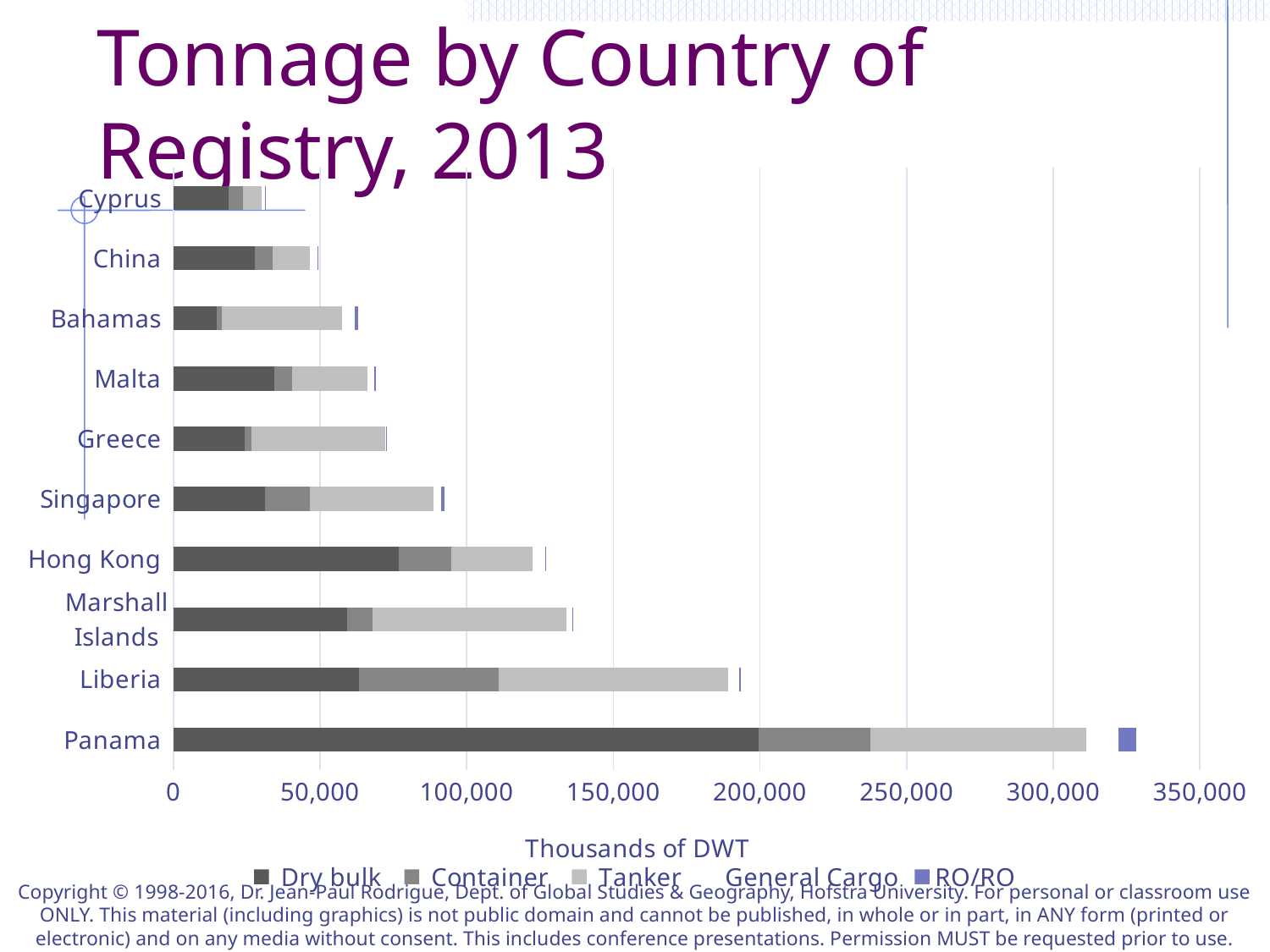
What kind of chart is shown on the slide? Stacked bar chart What is the first series listed in the legend? Dry bulk Is the total tonnage for Panama greater or less than 300,000? greater Is the total tonnage for Hong Kong greater or less than 100,000? greater Which country has the highest total tonnage? Panama How many series does the legend list? 5 What is the title of the x axis? Thousands of DWT How many countries are shown on the chart? 10 Which country has the lowest total tonnage? Cyprus Which has a larger total tonnage, Liberia or Marshall Islands? Liberia Which has a larger total tonnage, Hong Kong or Singapore? Hong Kong Is the total tonnage for Liberia greater or less than 200,000? less